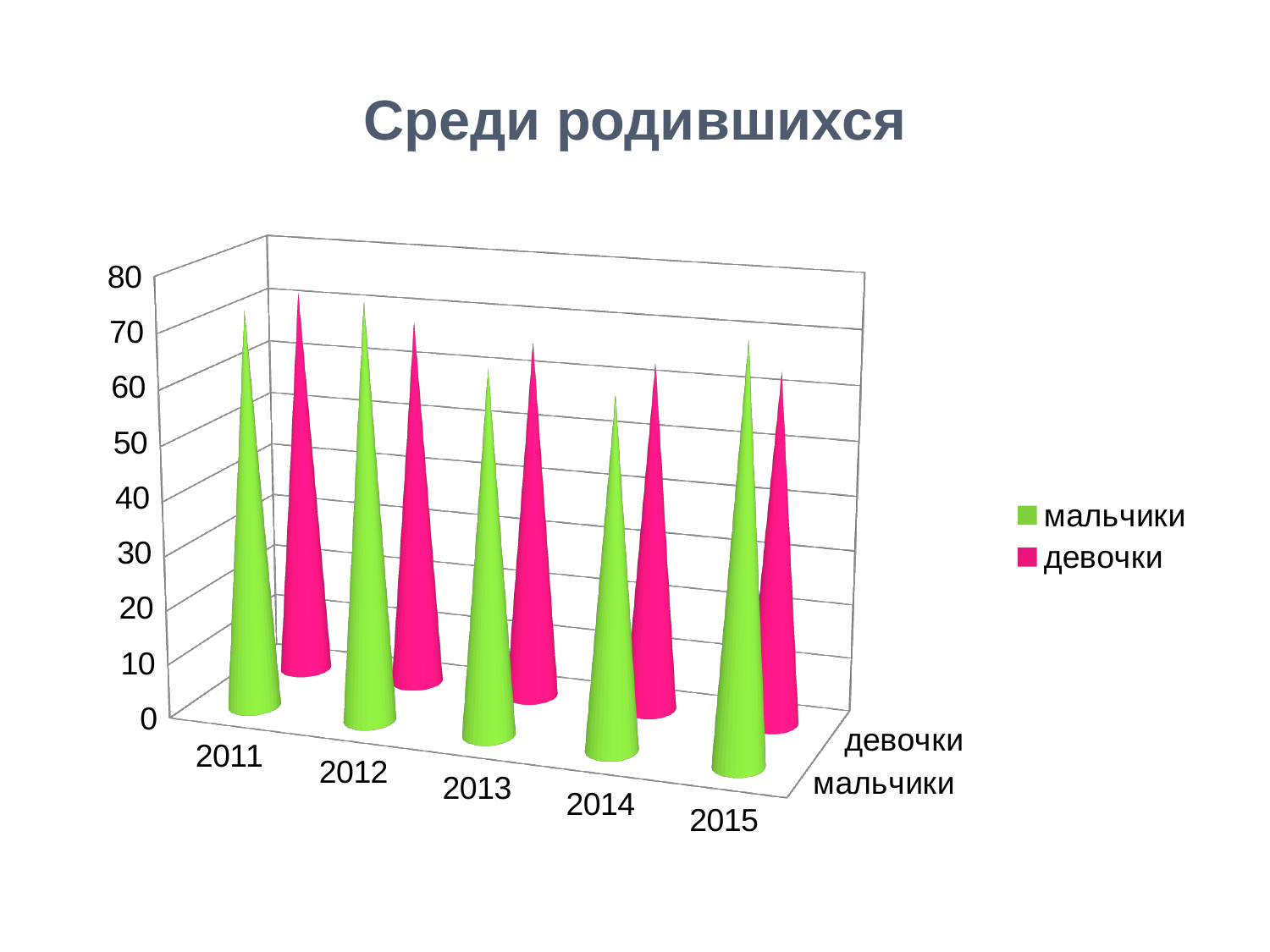
What are the two series named in the legend? мальчики, девочки What is the title of the chart? Среди родившихся Is the value for мальчики in 2014 greater or less than 40? greater Is the value for мальчики in 2013 greater or less than 30? greater Is the value for мальчики in 2011 greater or less than 50? greater How many series does the legend list? 2 How many years are shown on the x axis? 5 What kind of chart is shown on the slide? bar chart What is the first year shown on the x axis? 2011